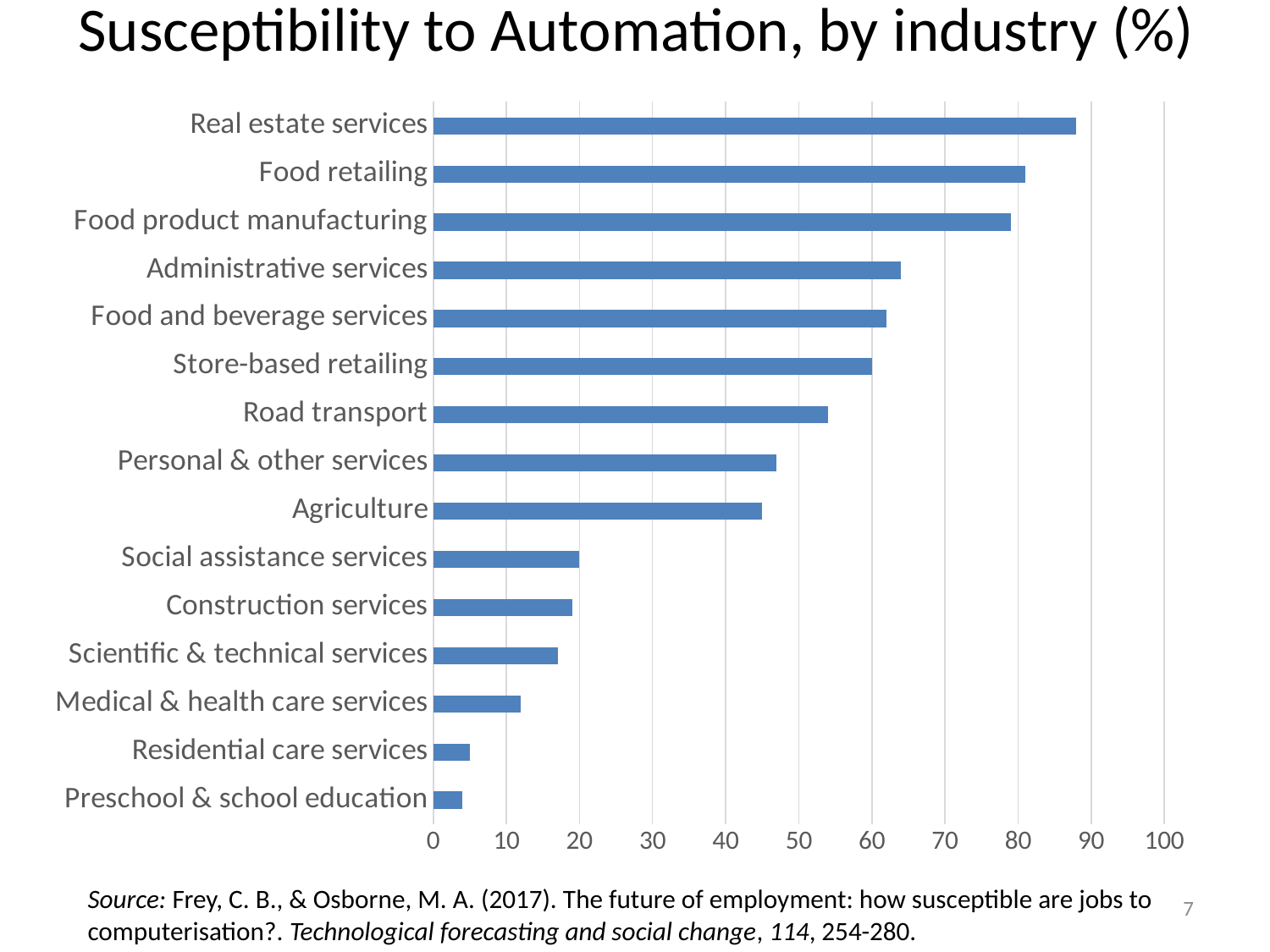
What type of chart is shown on the slide? Bar chart Which has a higher value, Road transport or Agriculture? Road transport How many industries are shown in the chart? 15 Which industry has the highest susceptibility to automation? Real estate services Is the value for Agriculture greater or less than 50? less Is the value for Medical & health care services greater or less than 20? less Is the value for Preschool & school education greater or less than 10? less What is the title of the chart? Susceptibility to Automation, by industry (%) Which has a higher value, Real estate services or Food retailing? Real estate services